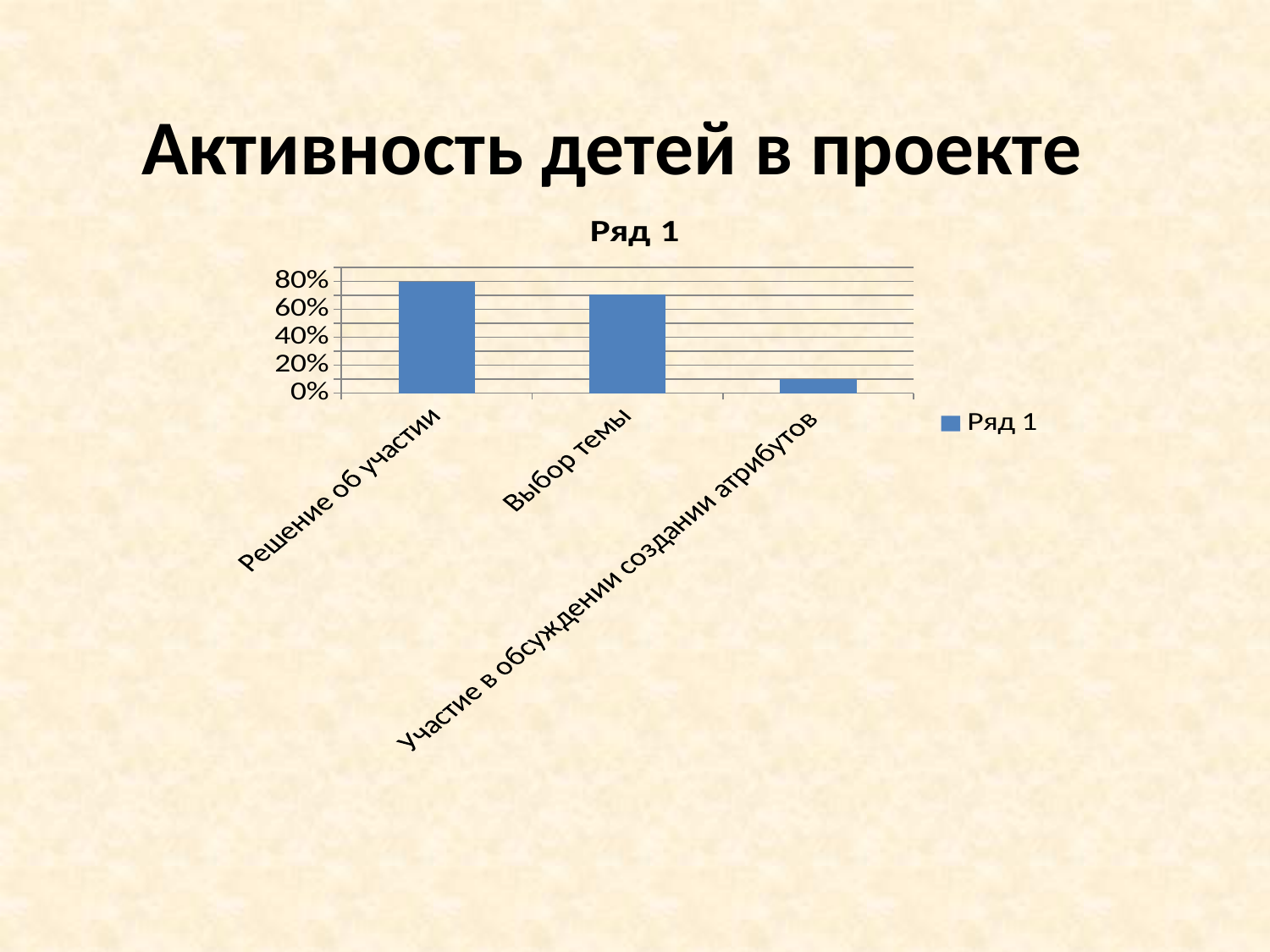
Which is larger, the value for Решение об участии or the value for Выбор темы? Решение об участии What kind of chart is shown on the slide? bar chart Which category has the lowest value? Участие в обсуждении создании атрибутов What is the title of the chart? Ряд 1 Is the value for Участие в обсуждении создании атрибутов greater or less than 20%? less Is the value for Решение об участии greater or less than 60%? greater What is the name of the series shown in the legend? Ряд 1 Is the value for Выбор темы greater or less than 60%? greater How many categories are plotted on the chart? 3 Do the values rise or fall from left to right along the x axis? fall Which category has the highest value? Решение об участии How many series does the legend list? 1